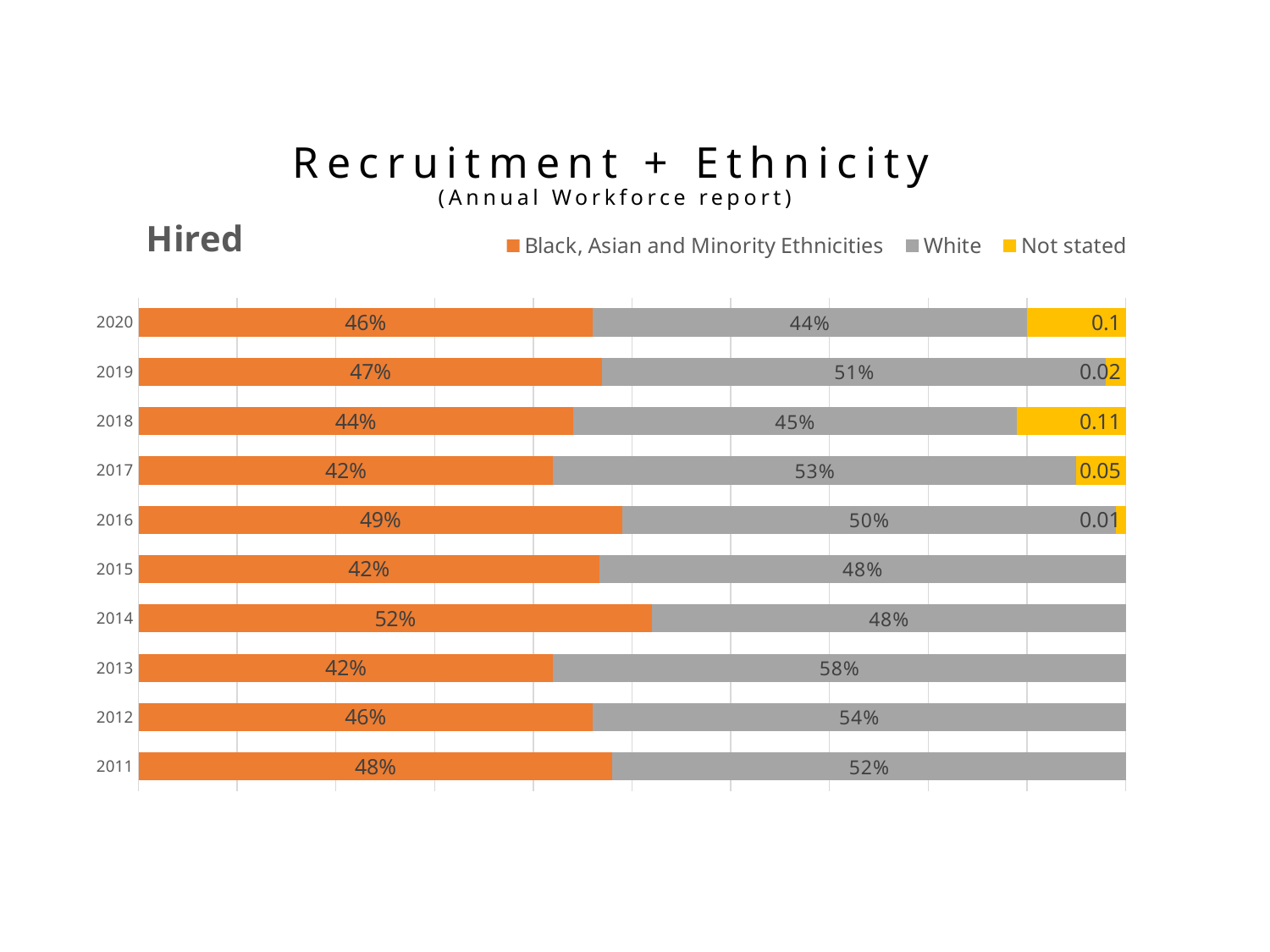
What kind of chart is shown on the slide? Stacked bar chart What is the value for White in 2013? 58% What is the value for White in 2019? 51% In 2016, which is larger: the White value or the Black, Asian and Minority Ethnicities value? White How many years are shown on the chart? 10 Which year has the lowest value for White? 2020 What is the Not stated value for 2018? 0.11 Which year has the highest value for Black, Asian and Minority Ethnicities? 2014 What is the value for Black, Asian and Minority Ethnicities in 2014? 52% How many series does the legend list? 3 Which year has the highest Not stated value? 2018 In 2013, how much larger is the White value than the Black, Asian and Minority Ethnicities value? 16%